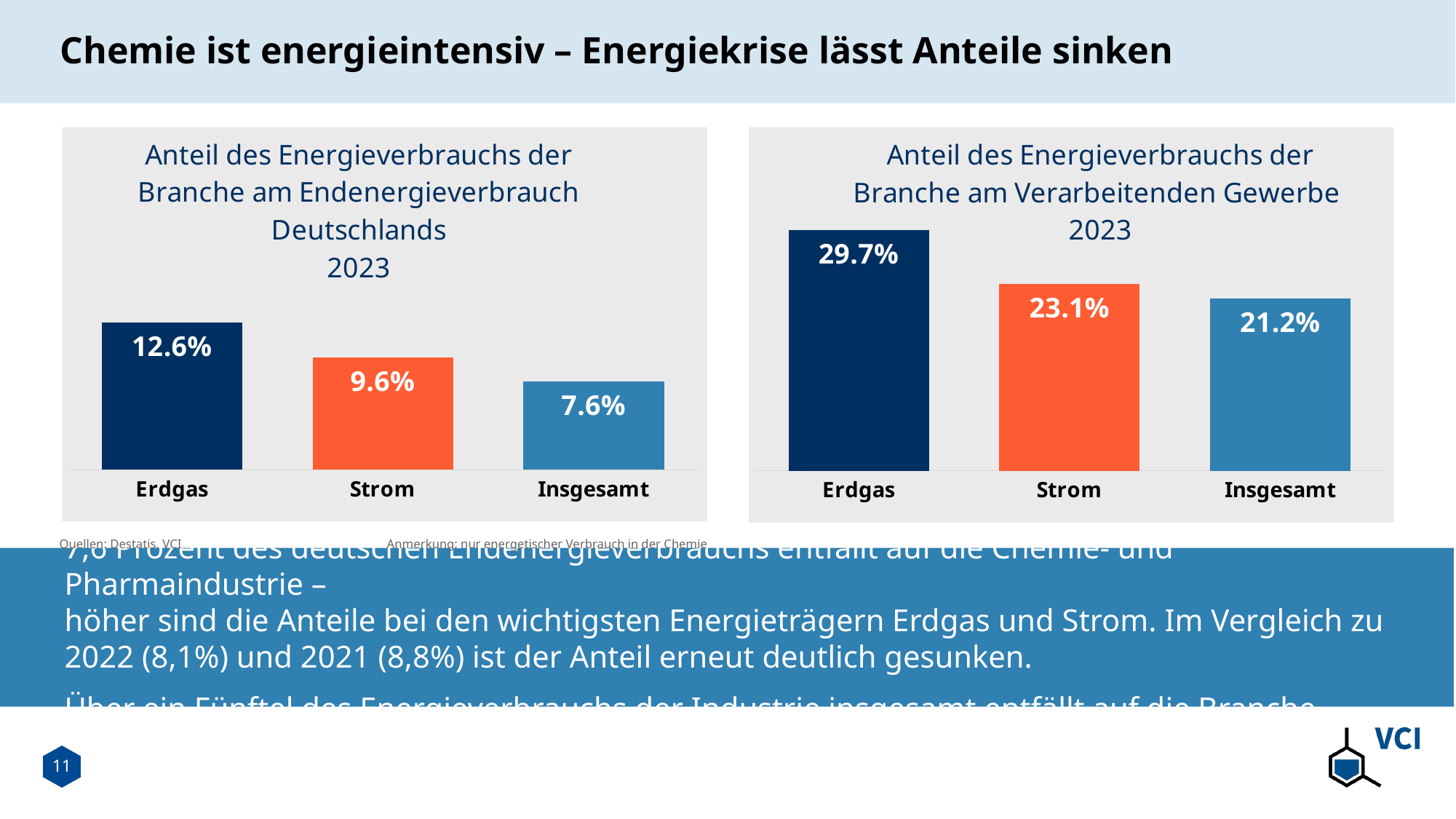
In the right chart (Verarbeitendes Gewerbe 2023), do the values rise or fall from Erdgas to Insgesamt? Fall In the right chart (Anteil des Energieverbrauchs der Branche am Verarbeitenden Gewerbe 2023), what is the value for Strom? 23.1% In the left chart (Endenergieverbrauch Deutschlands 2023), what is the value for Insgesamt? 7.6% What kind of chart is the left chart (Endenergieverbrauch Deutschlands 2023)? Bar chart In the right chart (Verarbeitendes Gewerbe 2023), what is the value for Insgesamt? 21.2% In the right chart (Verarbeitendes Gewerbe 2023), which category has the lowest value? Insgesamt In the right chart (Verarbeitendes Gewerbe 2023), what is the difference between the values for Erdgas and Insgesamt? 8.5% In the left chart (Anteil des Energieverbrauchs der Branche am Endenergieverbrauch Deutschlands 2023), what is the value for Erdgas? 12.6% In the left chart (Endenergieverbrauch Deutschlands 2023), what is the difference between the values for Erdgas and Strom? 3.0% How many categories are shown in the right chart (Verarbeitendes Gewerbe 2023)? 3 In the left chart (Endenergieverbrauch Deutschlands 2023), which category has the highest value? Erdgas Which is larger: the value for Strom in the left chart or the value for Strom in the right chart? Strom in the right chart